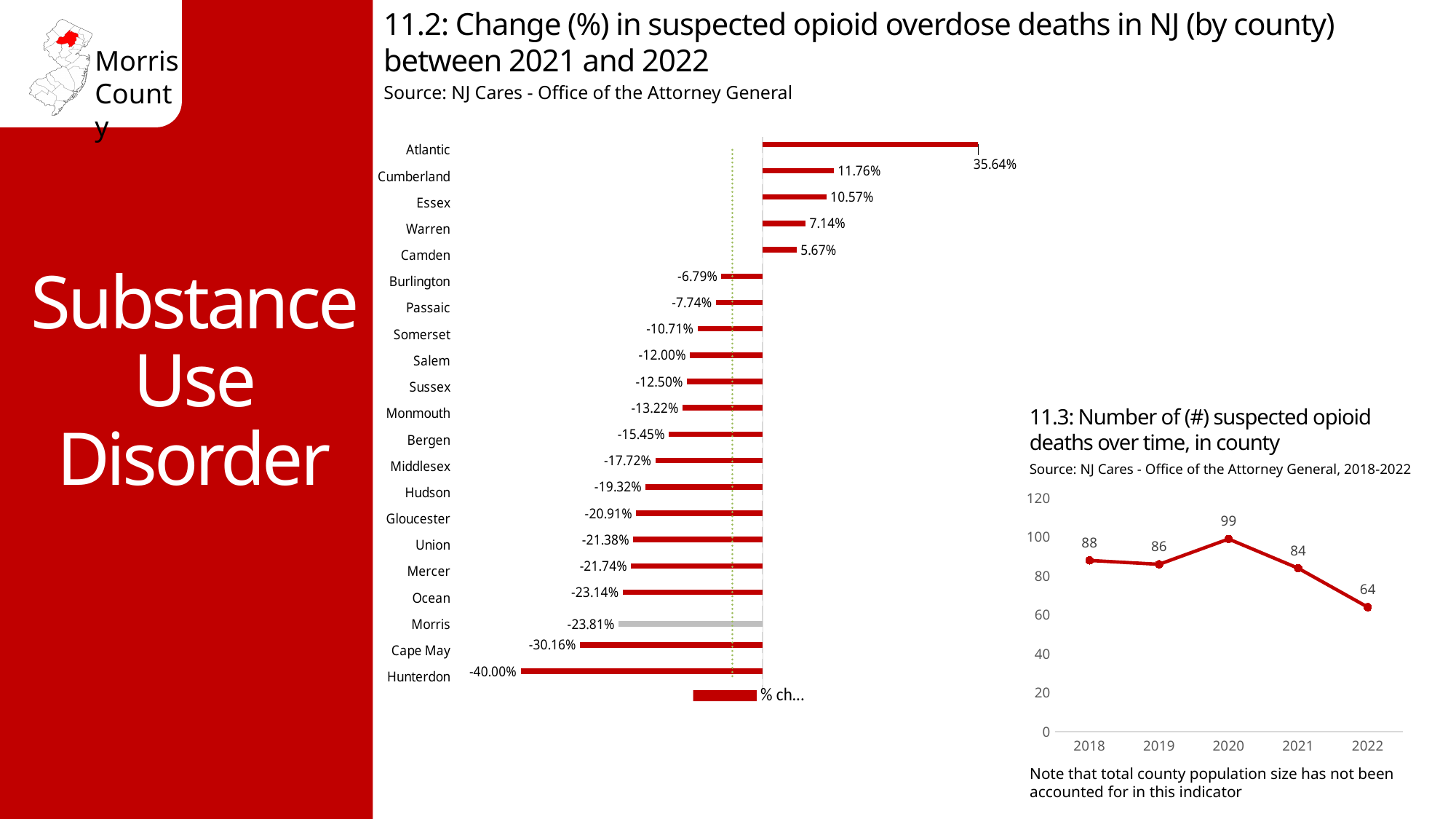
In chart 11.2, what is the value for Atlantic county? 35.64% In chart 11.3, what is the difference between the number of suspected opioid deaths in 2021 and 2022? 20 In chart 11.3, do the values rise or fall from 2020 to 2022? Fall In chart 11.3, how many years are plotted? 5 In chart 11.2, which county has the highest change (%) in suspected opioid overdose deaths? Atlantic In chart 11.2, which county has the larger value, Essex or Warren? Essex In chart 11.2, how many counties are shown? 21 In chart 11.2, which county has the lowest change (%) in suspected opioid overdose deaths? Hunterdon In chart 11.3, what is the number of suspected opioid deaths in 2020? 99 What type of chart is chart 11.2? Bar chart In chart 11.3, which year has the lowest number of suspected opioid deaths? 2022 In chart 11.2, what is the change (%) in suspected opioid overdose deaths for Morris county? -23.81%